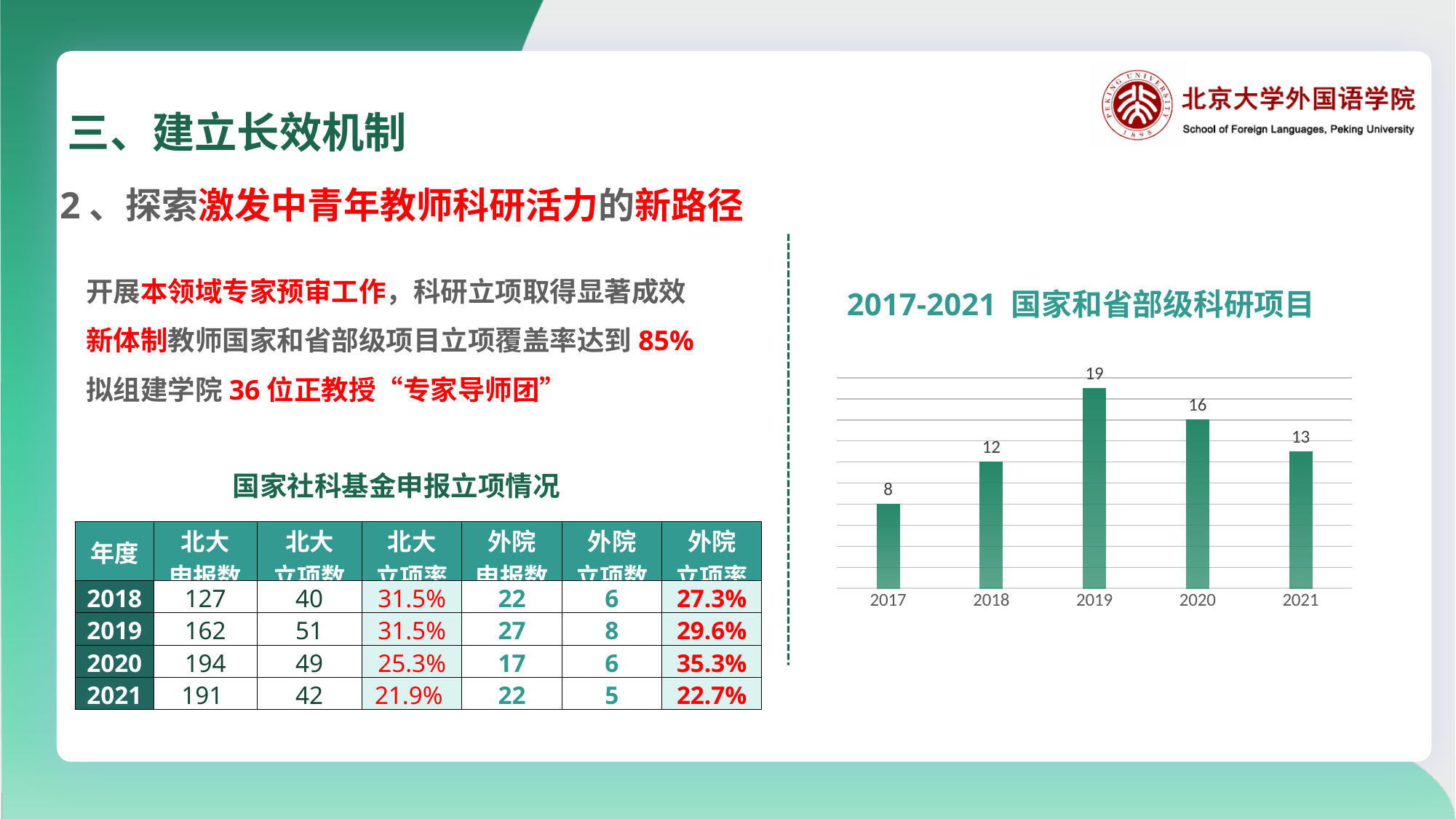
Do the values rise or fall from 2017 to 2019? rise What is the difference between the values for 2019 and 2017? 11 What is the value for 2019 in the chart? 19 What is the title of the chart? 2017-2021 国家和省部级科研项目 Which is larger, the value for 2018 or the value for 2020? 2020 What kind of chart is shown on the slide? bar chart How many years are shown on the x axis of the chart? 5 What is the difference between the values for 2020 and 2021? 3 Which year has the lowest value in the chart? 2017 What is the value for 2017 in the chart? 8 What is the value for 2021 in the chart? 13 Which year has the highest value in the chart? 2019